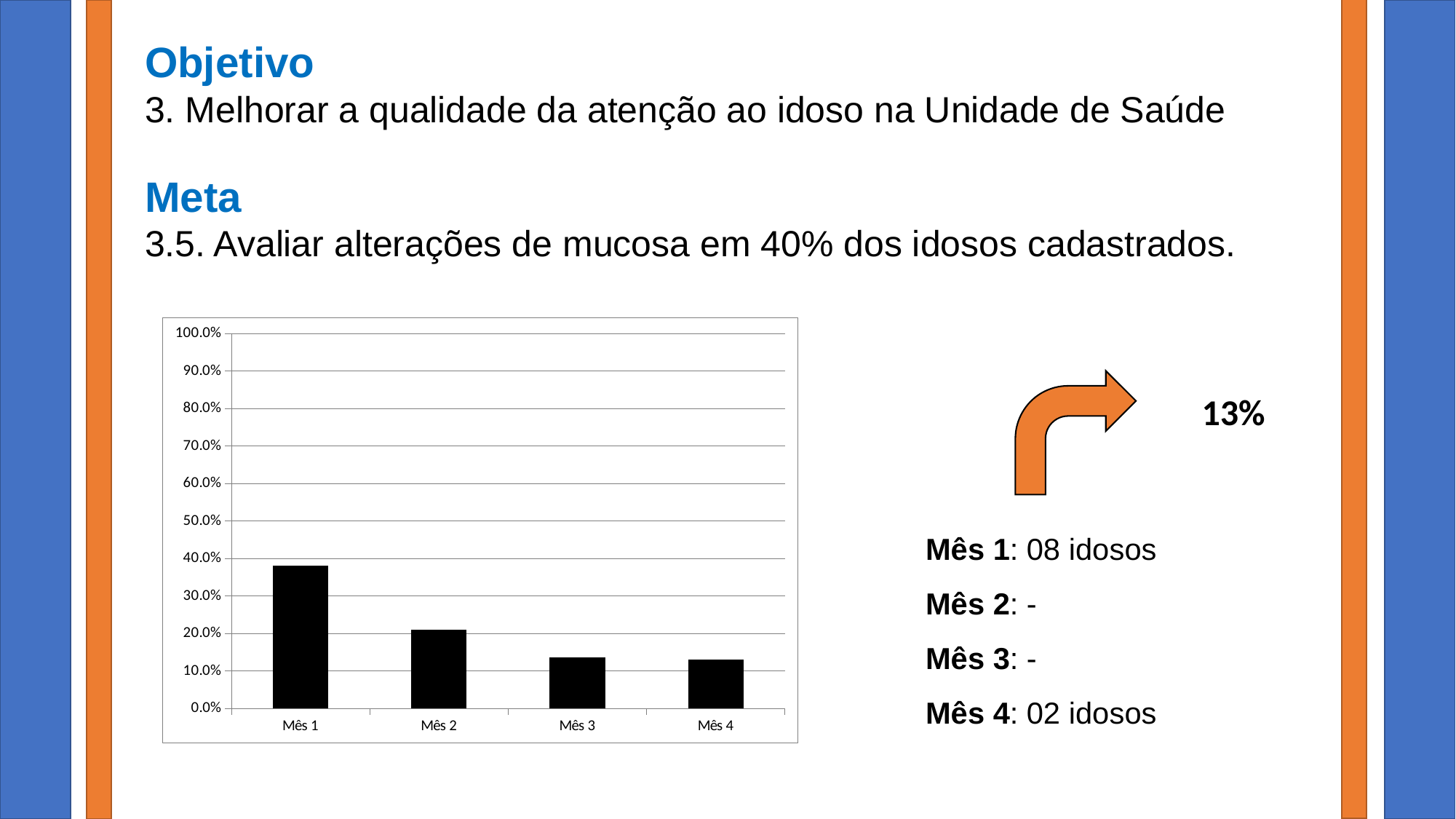
Which is larger, the value for Mês 1 or the value for Mês 2? Mês 1 How many categories are plotted on the x axis of the chart? 4 Is the value for Mês 4 greater or less than 10.0%? greater What is the highest tick value shown on the y axis of the chart? 100.0% Is the value for Mês 1 greater or less than 30.0%? greater Is the value for Mês 3 greater or less than 20.0%? less Which month has the highest bar in the chart? Mês 1 What kind of chart is shown on the slide? bar chart Which is larger, the value for Mês 2 or the value for Mês 4? Mês 2 Do the values rise or fall from Mês 1 to Mês 4? fall